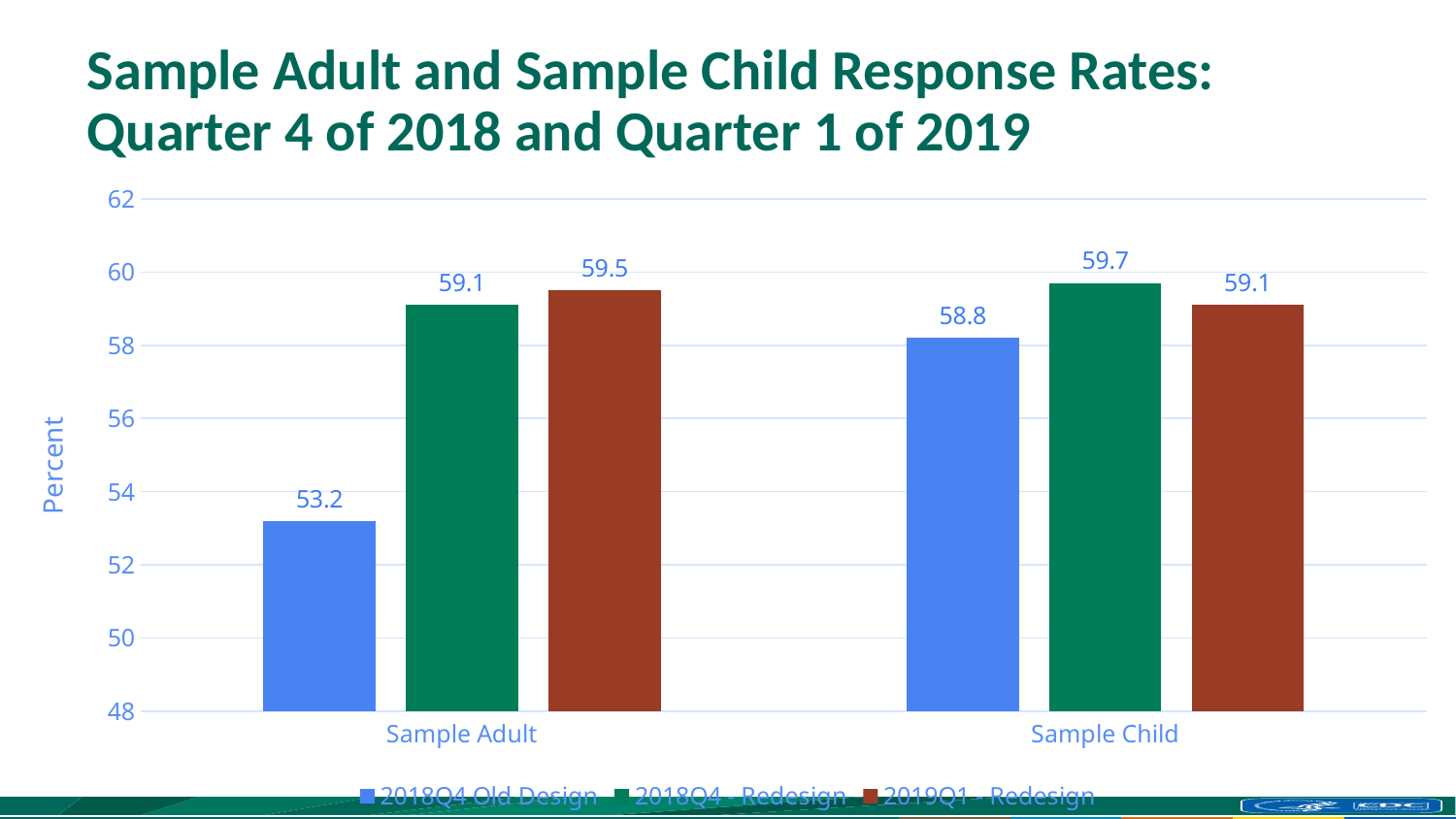
What is the difference between the 2018Q4 - Redesign and 2018Q4 Old Design response rates for Sample Adult? 5.9 What is the 2018Q4 - Redesign response rate for Sample Child? 59.7 Which series has the lowest response rate for Sample Child? 2018Q4 Old Design What is the difference between the 2018Q4 - Redesign and 2019Q1 - Redesign response rates for Sample Child? 0.6 Is the 2018Q4 Old Design response rate for Sample Adult greater or less than 54? less What is the 2018Q4 Old Design response rate for Sample Adult? 53.2 What is the 2019Q1 - Redesign response rate for Sample Child? 59.1 Which series has the highest response rate for Sample Adult? 2019Q1 - Redesign How many series does the legend list? 3 What kind of chart is shown on the slide? Bar chart Which is larger: the 2018Q4 Old Design response rate for Sample Adult or for Sample Child? Sample Child How many categories are shown on the x axis? 2